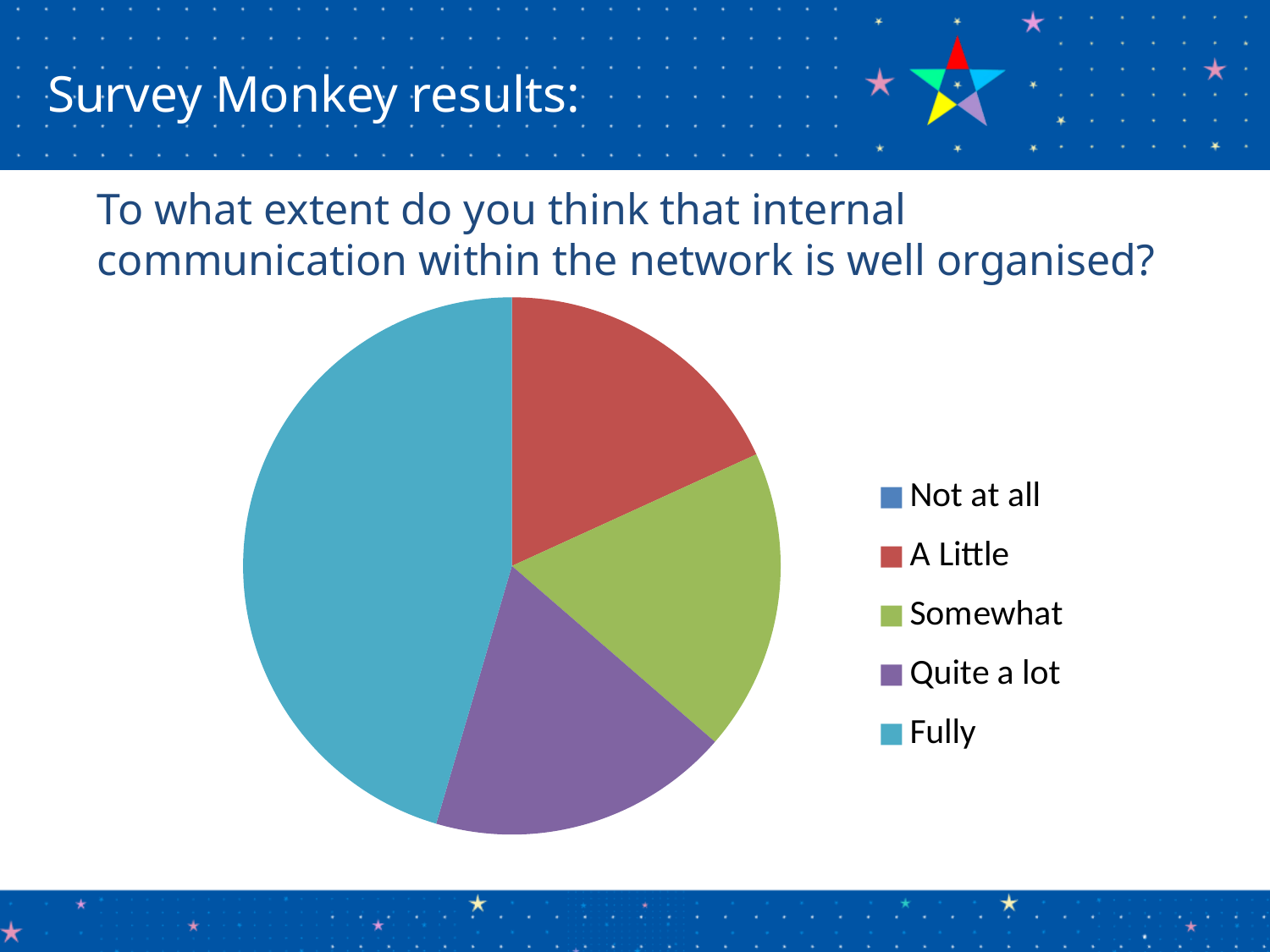
What kind of chart is shown on the slide? pie chart Which legend entry has no visible slice in the pie chart? Not at all Which slice is larger, Fully or Somewhat? Fully How many slices are visible in the pie chart? 4 Which category has the largest slice of the pie chart? Fully Which slice is larger, Fully or A Little? Fully How many entries does the legend of the pie chart list? 5 What survey question does the pie chart present results for? To what extent do you think that internal communication within the network is well organised? Which slice is larger, Fully or Quite a lot? Fully